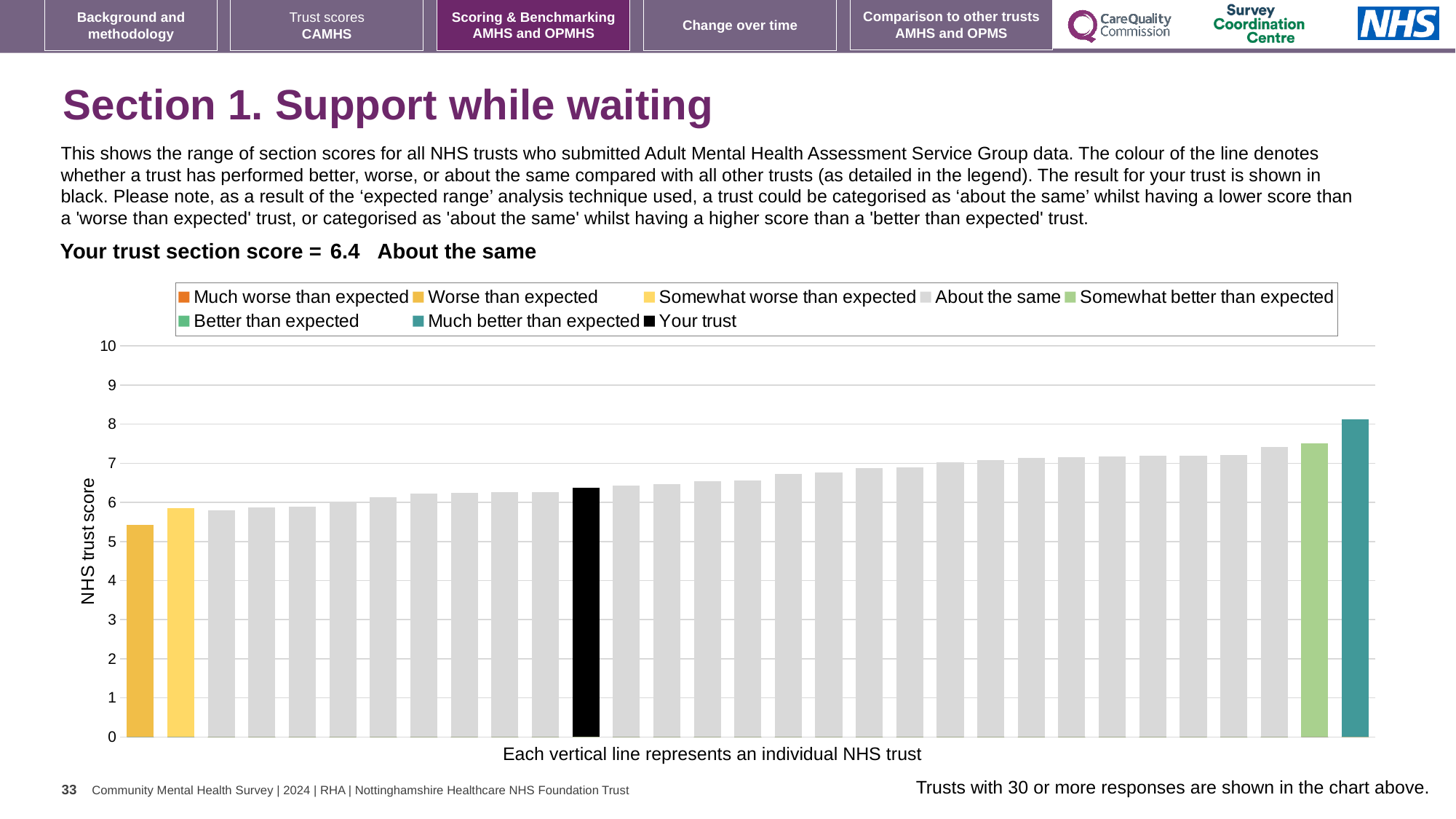
Which is larger, the leftmost bar or the rightmost bar? the rightmost bar Do the bar values rise or fall from left to right along the x axis? rise How many entries does the chart legend list? 8 Is the value for the rightmost bar greater or less than 7? greater What is the label on the vertical axis of the chart? NHS trust score Is the value for the light green bar (Somewhat better than expected) greater or less than 7? greater What is the section score for your trust? 6.4 Which legend category does the highest bar belong to? Much better than expected Is the value for the leftmost bar greater or less than 6? less What kind of chart is shown on the slide? bar chart Which category is your trust's section score placed in? About the same